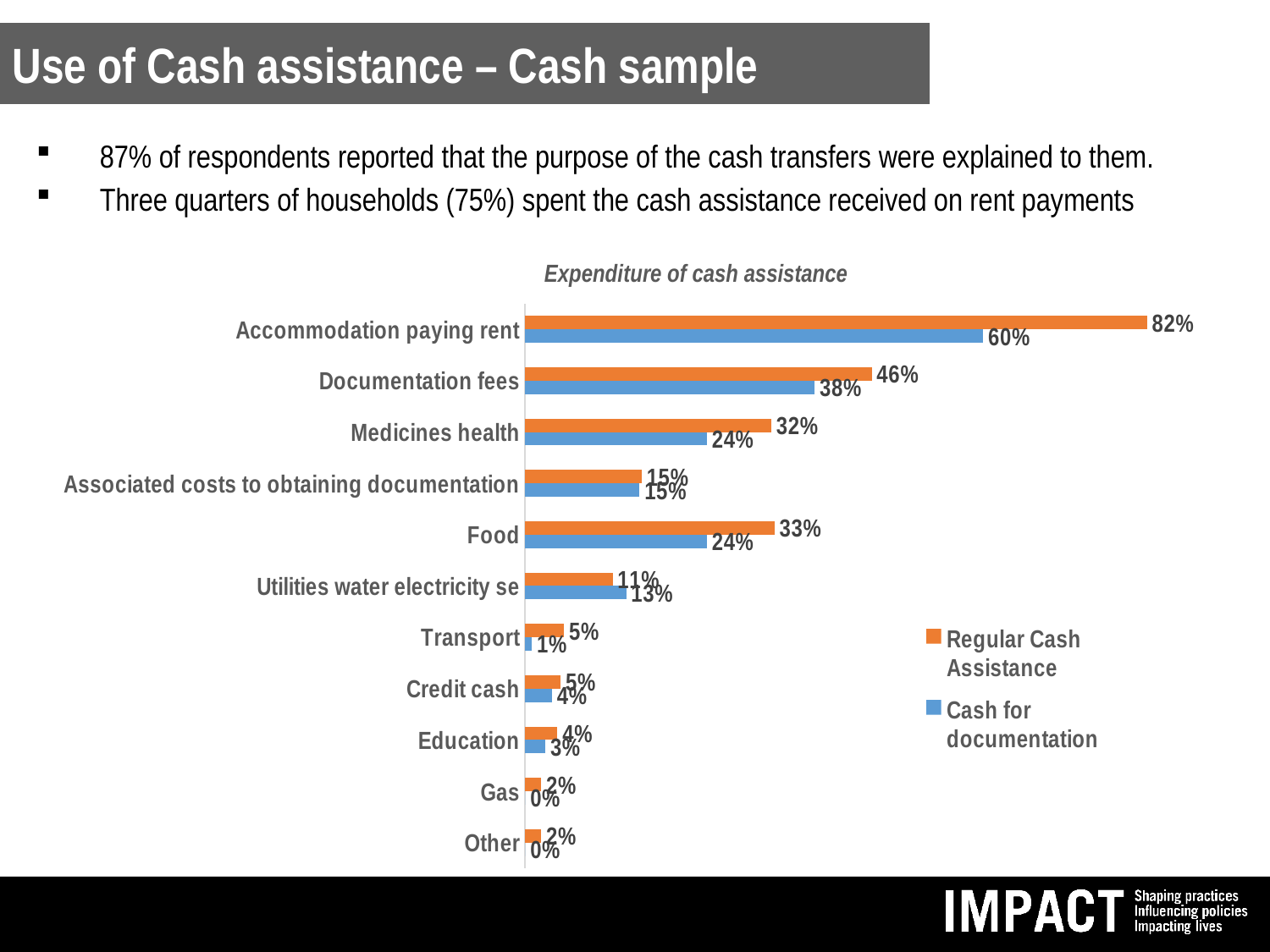
What type of chart is shown under the title "Expenditure of cash assistance"? Bar chart What is the Cash for documentation value for Documentation fees? 38% How many series does the legend of the "Expenditure of cash assistance" chart list? 2 What is the difference between the Regular Cash Assistance and Cash for documentation values for Accommodation paying rent? 22% What is the Regular Cash Assistance value for Accommodation paying rent? 82% Which category has the highest Regular Cash Assistance value? Accommodation paying rent What is the difference between the Regular Cash Assistance and Cash for documentation values for Medicines health? 8% Which colour represents the Regular Cash Assistance series in the chart? Orange For Utilities water electricity se, which series has the larger value: Regular Cash Assistance or Cash for documentation? Cash for documentation How many expenditure categories are shown in the "Expenditure of cash assistance" chart? 11 What is the Regular Cash Assistance value for Food? 33% What is the Cash for documentation value for Gas? 0%